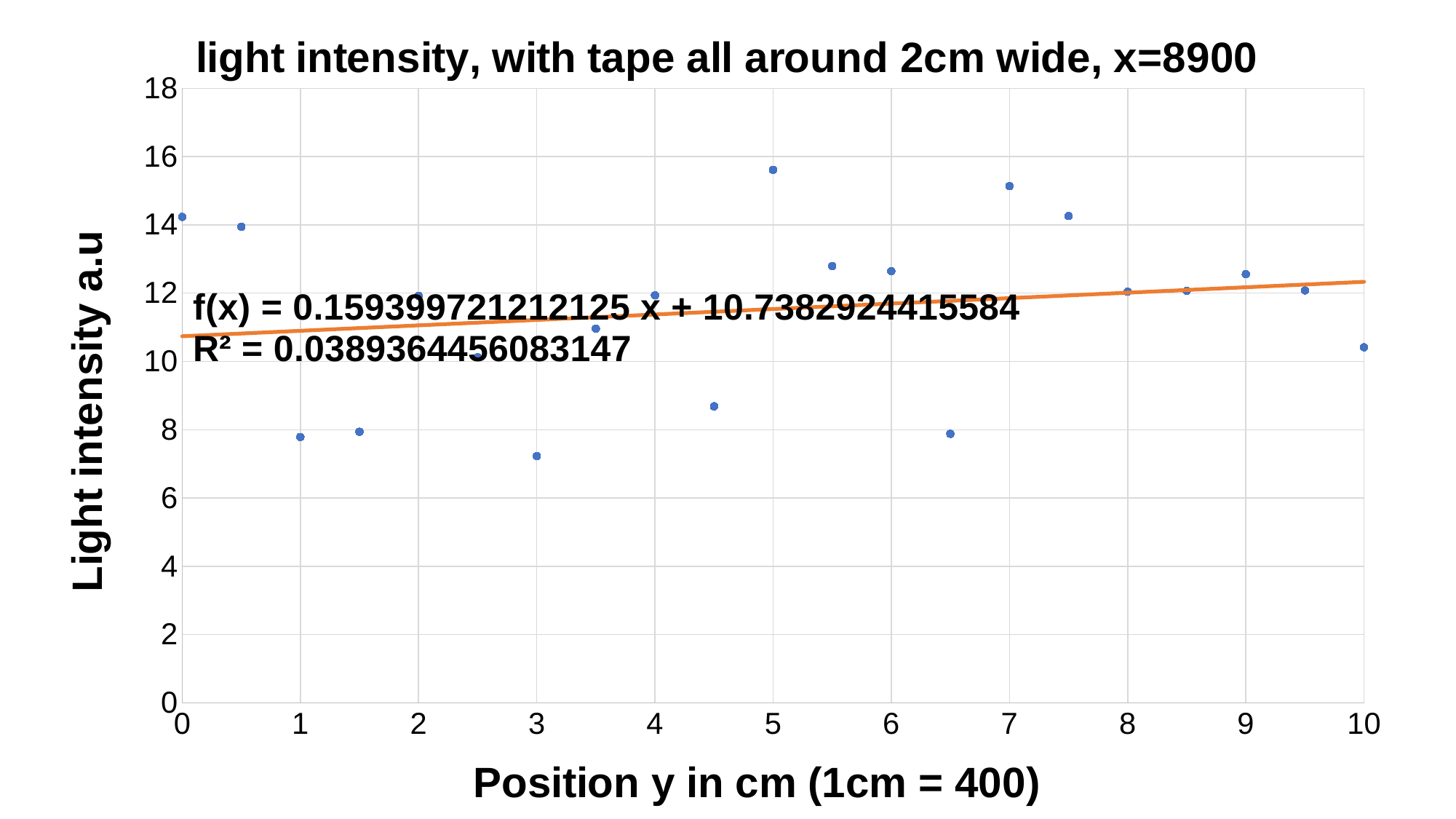
Is the light intensity at position 3 greater or less than 8? less Is the light intensity at position 5 greater or less than 14? greater Does the fitted trend line rise or fall as position increases? rise At which x position is the light intensity highest? 5 What is the label of the x axis? Position y in cm (1cm = 400) Is the light intensity at position 1 greater or less than 10? less What kind of chart is shown on the slide? scatter chart Which has the higher light intensity, position 0 or position 1? position 0 At which x position is the light intensity lowest? 3 How many data points are plotted in the chart? 21 What is the title of the chart? light intensity, with tape all around 2cm wide, x=8900